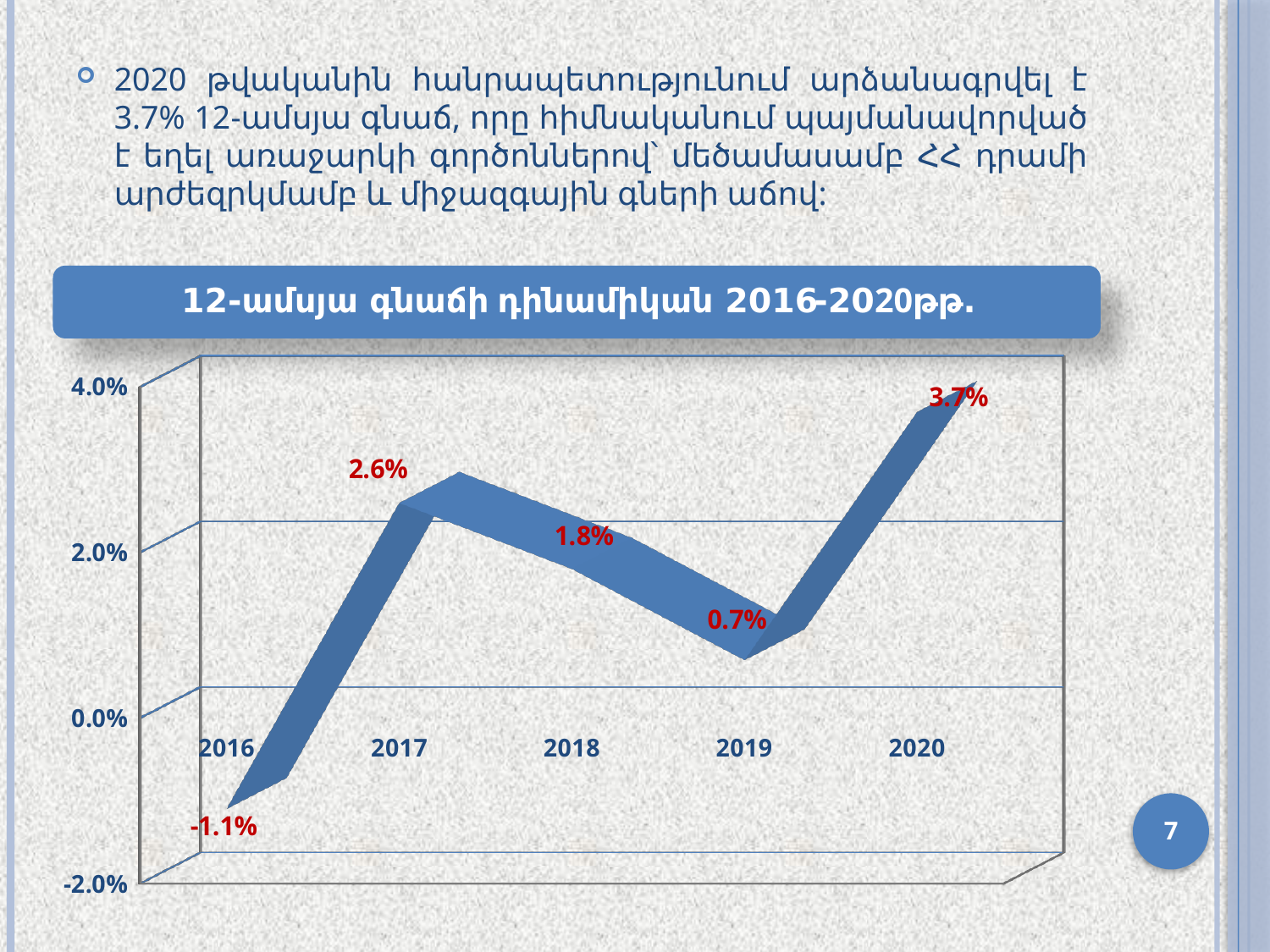
Do the values rise or fall from 2017 to 2019? fall What kind of chart is shown on the slide? line chart What is the value for 2020? 3.7% Which year has the highest value? 2020 What is the difference between the values for 2020 and 2019? 3.0% Which is larger, the value for 2017 or the value for 2018? 2017 What is the value for 2016? -1.1% How many years are plotted on the chart? 5 Which year has the lowest value? 2016 What is the value for 2017? 2.6% What is the value for 2018? 1.8% What is the value for 2019? 0.7%